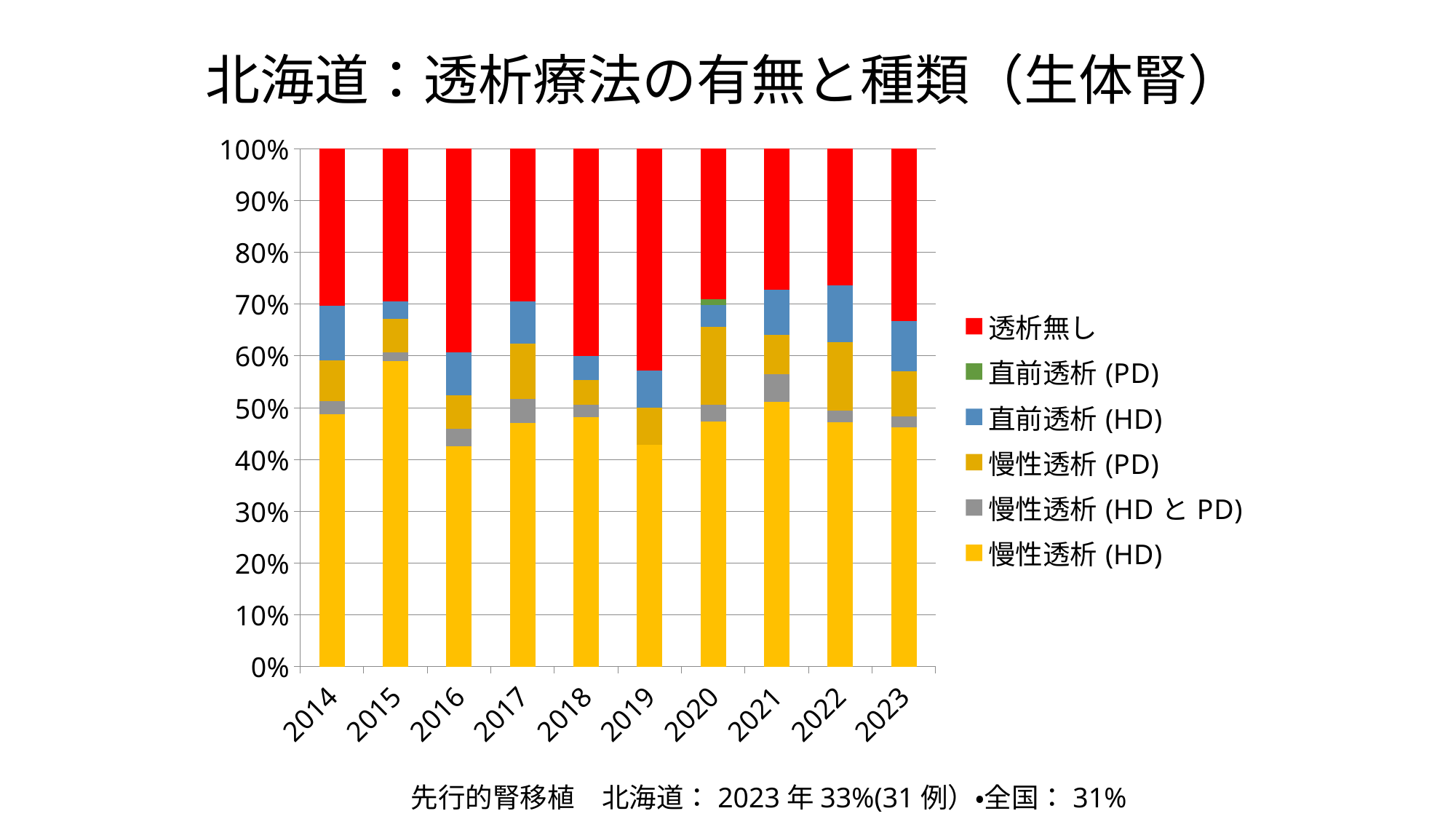
Is the 慢性透析 (HD) share for 2015 greater or less than 50%? greater Is the 透析無し share for 2019 greater or less than 40%? greater Which colour represents 透析無し in the chart? red Is the 慢性透析 (HD) share for 2023 greater or less than 50%? less What kind of chart is shown on the slide? stacked bar chart Which year has the largest 透析無し share? 2019 What is the title of the chart? 北海道：透析療法の有無と種類（生体腎） Which is larger, the 慢性透析 (HD) share in 2015 or in 2019? 2015 How many years are shown on the x axis of the chart? 10 Which year has the largest 慢性透析 (HD) share? 2015 How many series does the legend list? 6